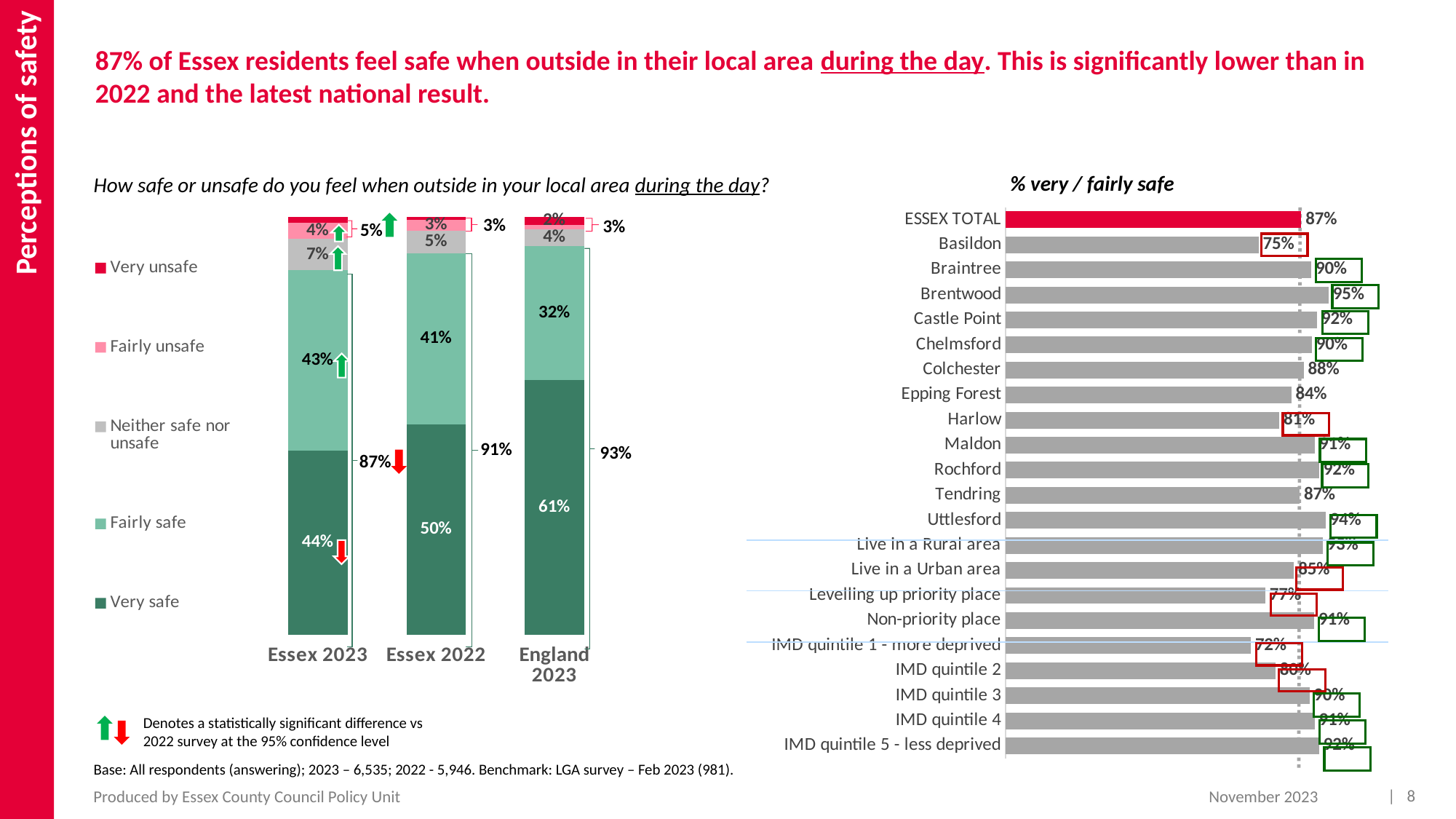
In the left chart, what is the combined very/fairly safe figure shown for Essex 2022? 91% In the '% very / fairly safe' chart, what is the value for Basildon? 75% What kind of chart is the chart on the left of the slide? Stacked bar chart How many series does the legend of the left chart list? 5 In the left chart, what percentage of Essex 2023 respondents feel very safe? 44% How many categories are plotted in the '% very / fairly safe' chart? 22 In the '% very / fairly safe' chart, which category has the lowest value? IMD quintile 1 - more deprived In the '% very / fairly safe' chart, what is the value for Brentwood? 95% In the '% very / fairly safe' chart, which is higher, Colchester or Epping Forest? Colchester In the left chart, what percentage of England 2023 respondents feel fairly safe? 32% In the left chart, what is the difference in percentage points between the very safe share for England 2023 and for Essex 2023? 17 percentage points In the '% very / fairly safe' chart, what is the difference in percentage points between Braintree and Harlow? 9 percentage points